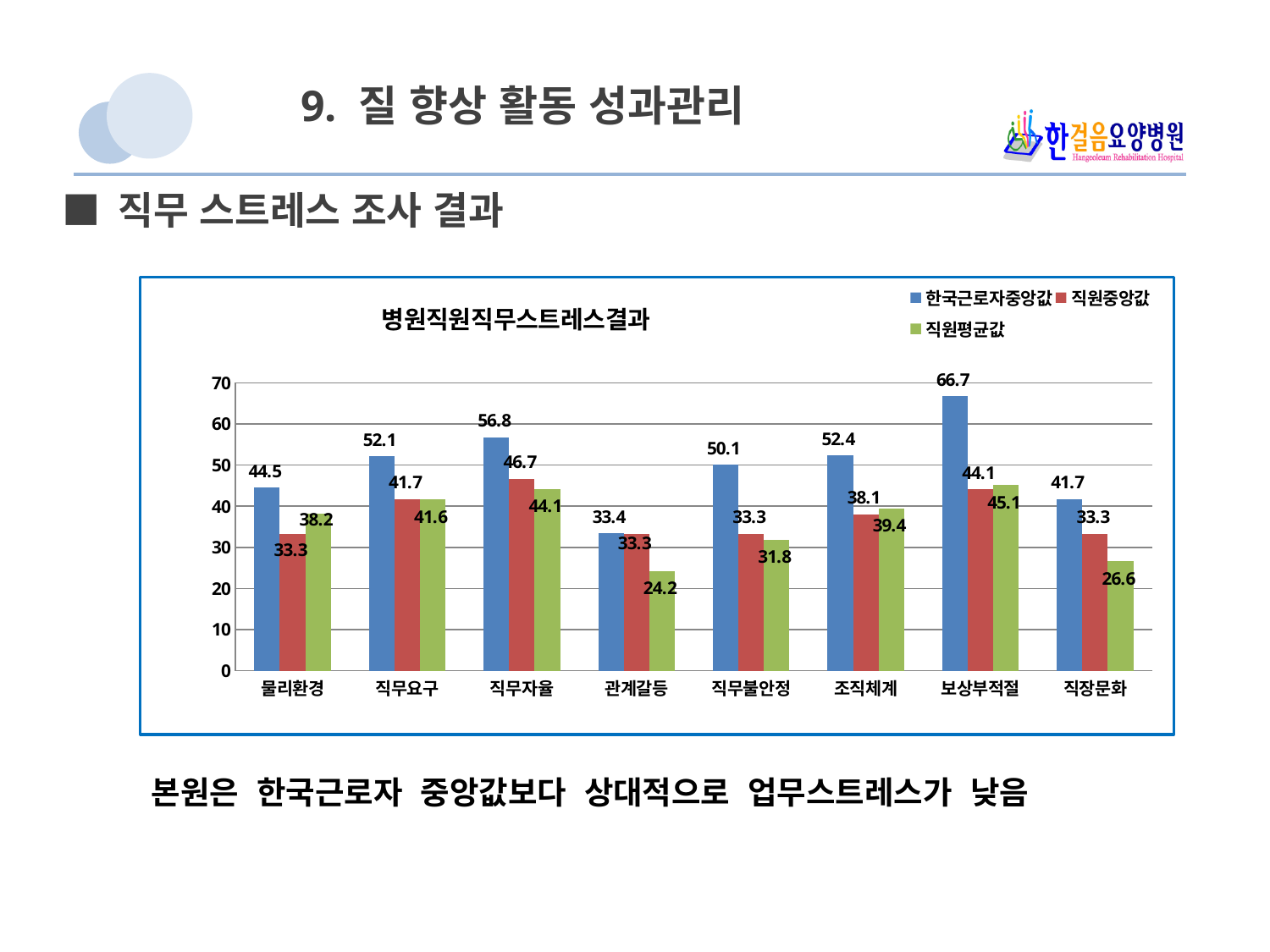
How many series does the legend list? 3 What is the 한국근로자중앙값 value for 보상부적절? 66.7 Which category has the highest 한국근로자중앙값 value? 보상부적절 Which is larger for 조직체계: the 직원중앙값 value or the 직원평균값 value? 직원평균값 What is the 직원평균값 value for 관계갈등? 24.2 Which category has the lowest 직원평균값 value? 관계갈등 What is the title of the chart? 병원직원직무스트레스결과 What is the difference between the 한국근로자중앙값 and 직원중앙값 values for 보상부적절? 22.6 What is the 직원중앙값 value for 직무자율? 46.7 How many categories are shown on the x axis? 8 Which series is shown in green in the legend? 직원평균값 What kind of chart is shown? Bar chart